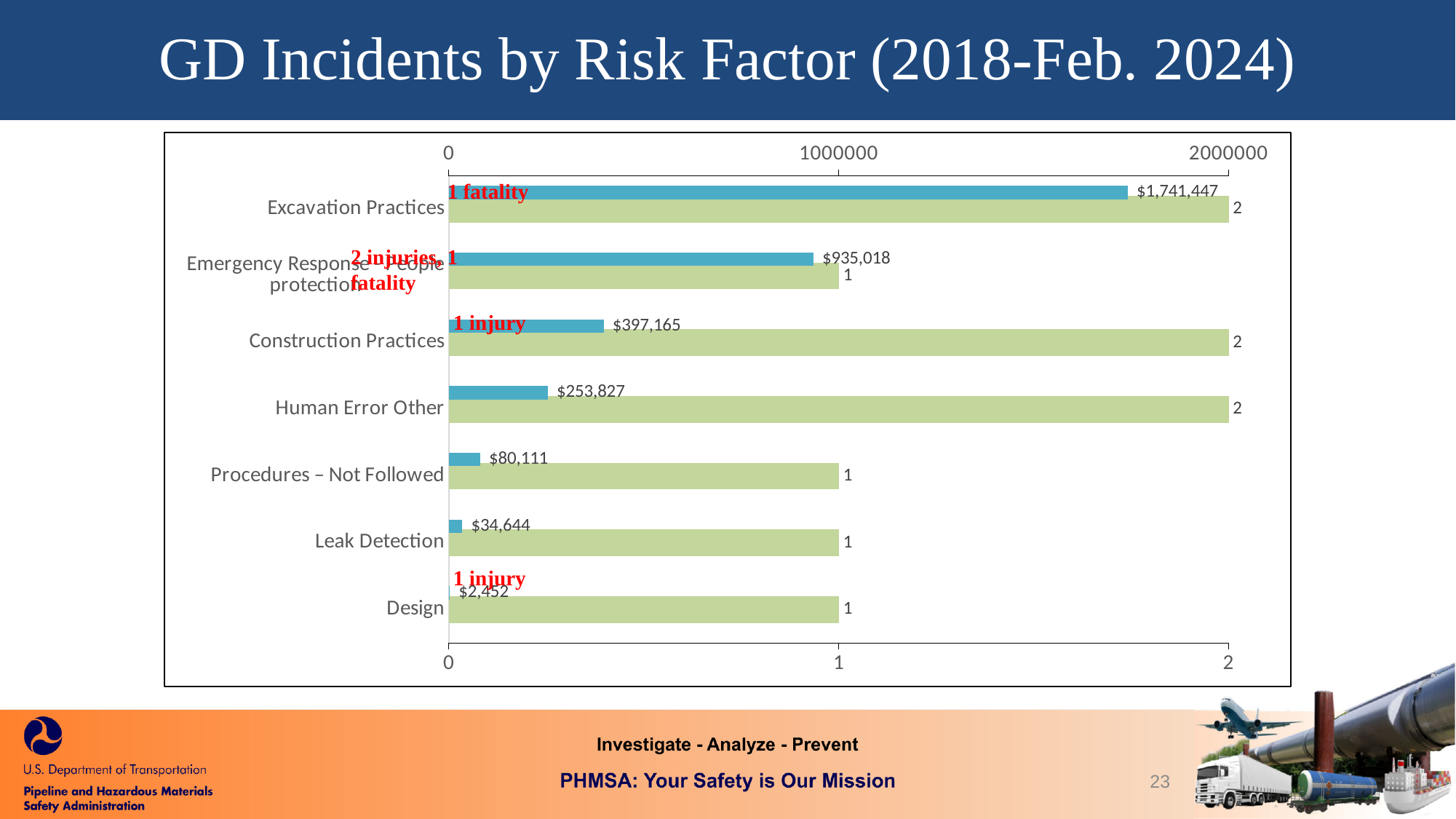
Which risk factor has the highest dollar value? Excavation Practices What is the dollar value shown for Construction Practices? $397,165 What red annotation is shown next to the Excavation Practices bar? 1 fatality How many risk factor categories are shown on the chart? 7 What is the dollar value shown for Excavation Practices? $1,741,447 What kind of chart is shown on the slide? bar chart Which has a larger dollar value, Construction Practices or Human Error Other? Construction Practices What is the incident count (green bar) shown for Human Error Other? 2 Which risk factor has the lowest dollar value? Design What is the difference between the dollar values for Excavation Practices and Emergency Response – People protection? $806,429 Is the dollar value for Emergency Response – People protection greater or less than 1000000? less What is the dollar value shown for Leak Detection? $34,644